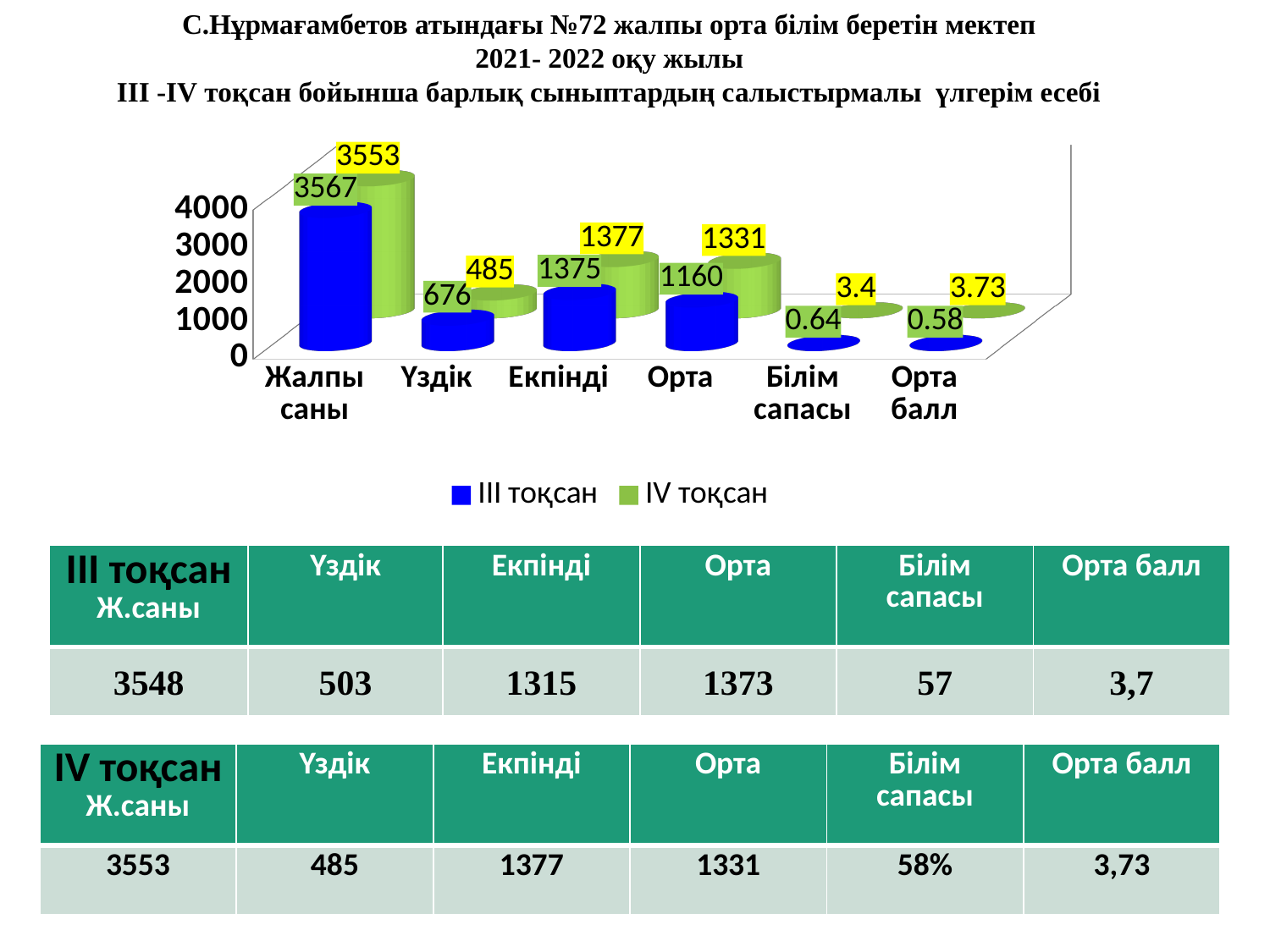
What is the value for Жалпы саны in the IV тоқсан series? 3553 How many categories are shown on the x axis of the chart? 6 What is the difference between the IV тоқсан and III тоқсан values for Орта? 171 What is the value for Жалпы саны in the III тоқсан series? 3567 What is the value for Орта балл in the IV тоқсан series? 3.73 What is the value for Орта in the III тоқсан series? 1160 What is the value for Үздік in the IV тоқсан series? 485 Which is larger for Үздік: the III тоқсан value or the IV тоқсан value? III тоқсан What type of chart is shown on the slide? Bar chart Which category has the highest value in the III тоқсан series? Жалпы саны What is the difference between the III тоқсан and IV тоқсан values for Үздік? 191 How many series does the chart legend list? 2